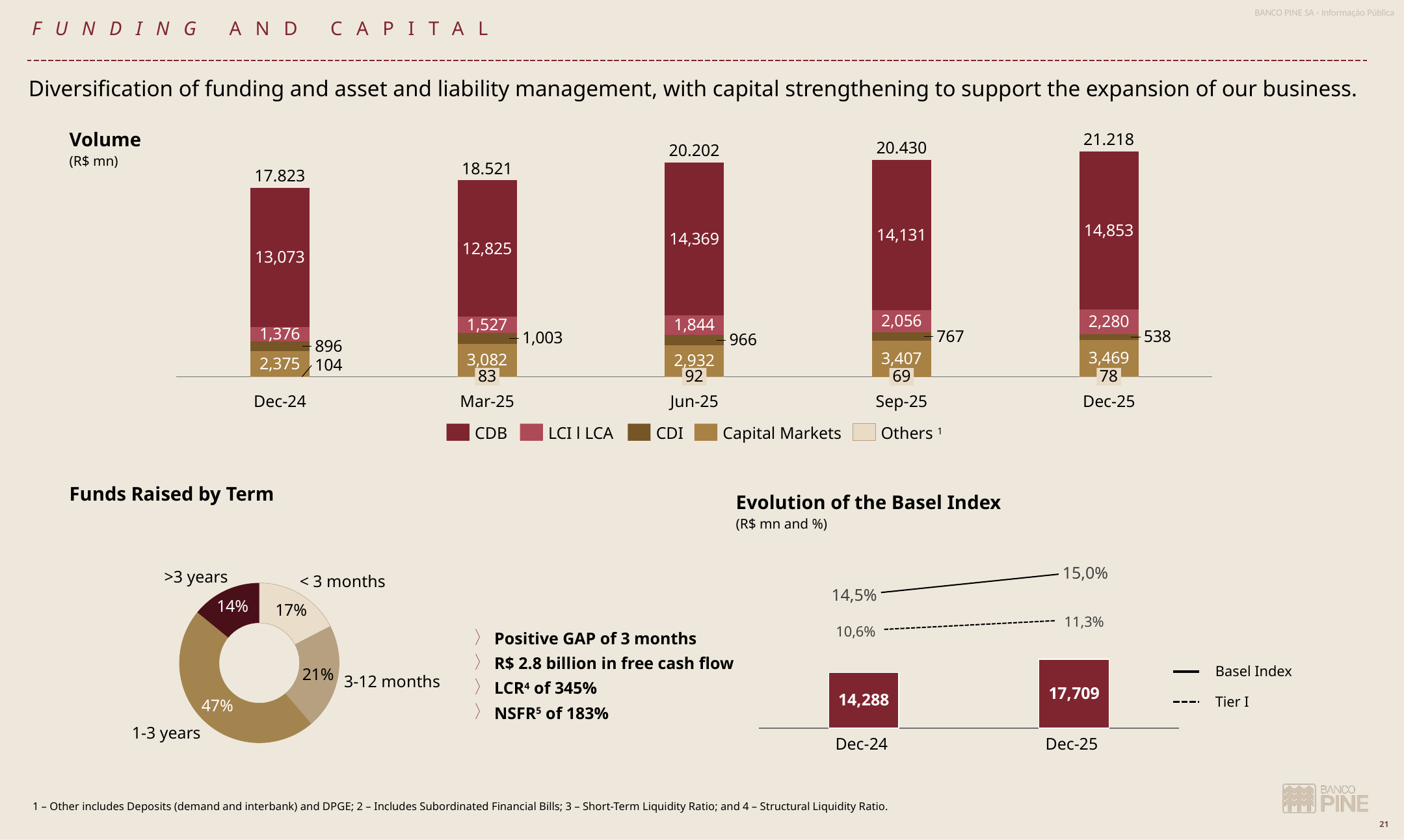
In the Funds Raised by Term chart, which term has the smallest share? >3 years In the Volume chart, what is the CDB value for Dec-25? 14,853 In the Evolution of the Basel Index chart, what is the difference between the bar values for Dec-25 and Dec-24? 3,421 In the Volume chart, what is the Capital Markets value for Sep-25? 3,407 In the Volume chart, what is the difference between the LCI | LCA values for Dec-25 and Dec-24? 904 In the Evolution of the Basel Index chart, what is the Tier I value for Dec-25? 11,3% In the Volume chart, how many series does the legend list? 5 In the Volume chart, what is the total for Jun-25? 20.202 In the Volume chart, do the totals rise or fall from Dec-24 to Dec-25? rise In the Volume chart, which period has the lowest CDI value? Dec-25 In the Volume chart, which period has the highest total? Dec-25 In the Funds Raised by Term chart, what share is 1-3 years? 47%